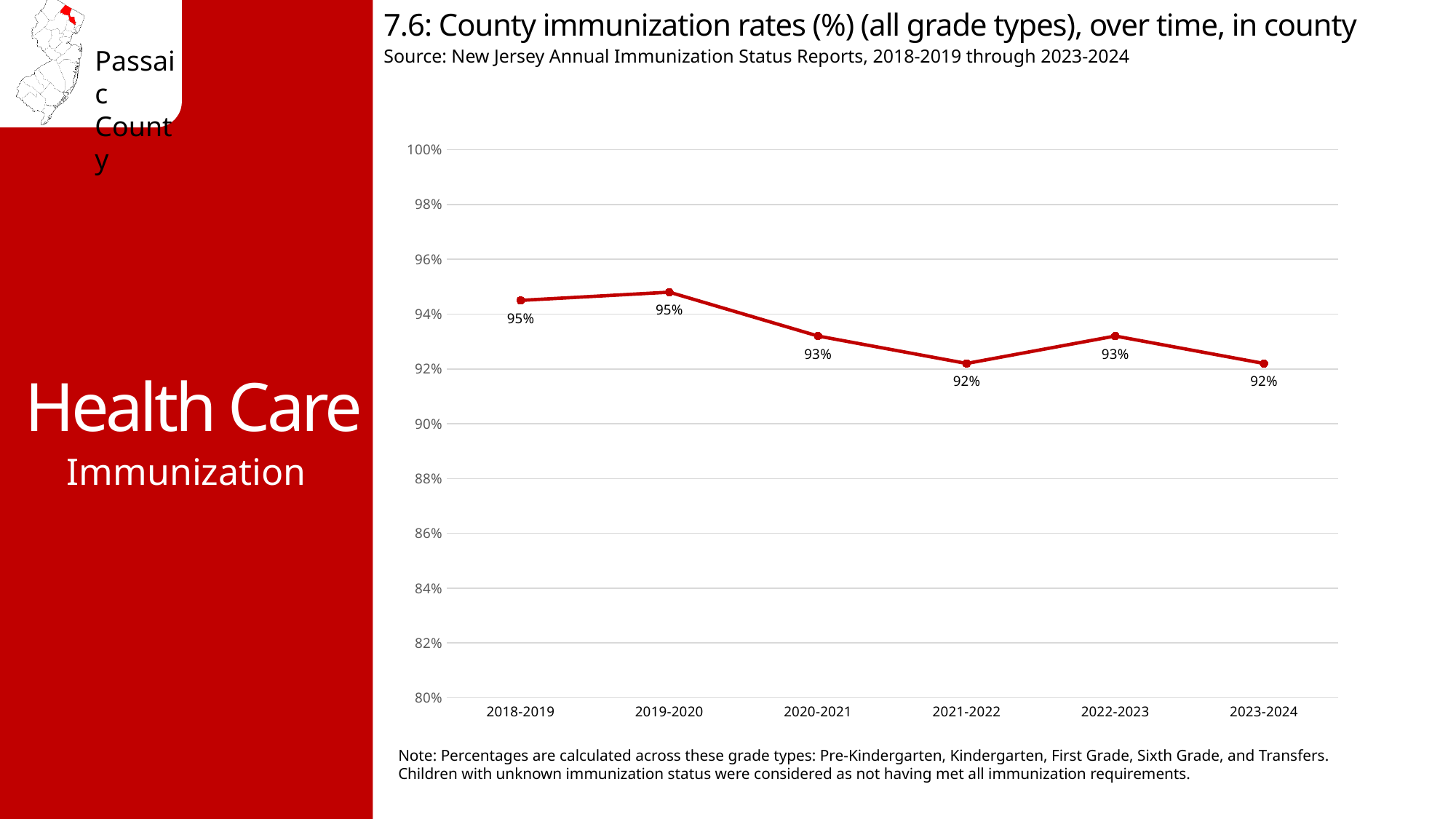
Is the immunization rate for 2020-2021 greater or less than 94%? less Overall, does the county immunization rate rise or fall from 2018-2019 to 2023-2024? fall Which is larger, the immunization rate in 2018-2019 or in 2021-2022? 2018-2019 What is the difference between the immunization rate in 2019-2020 and in 2021-2022? 3 percentage points What is the county immunization rate for 2023-2024? 92% How many school years are plotted on the chart? 6 What kind of chart is shown on the slide? line chart Is the immunization rate for 2019-2020 greater or less than 94%? greater What is the county immunization rate for 2020-2021? 93% What is the difference between the immunization rate in 2018-2019 and in 2020-2021? 2 percentage points What is the county immunization rate for 2021-2022? 92% What is the county immunization rate for 2018-2019? 95%